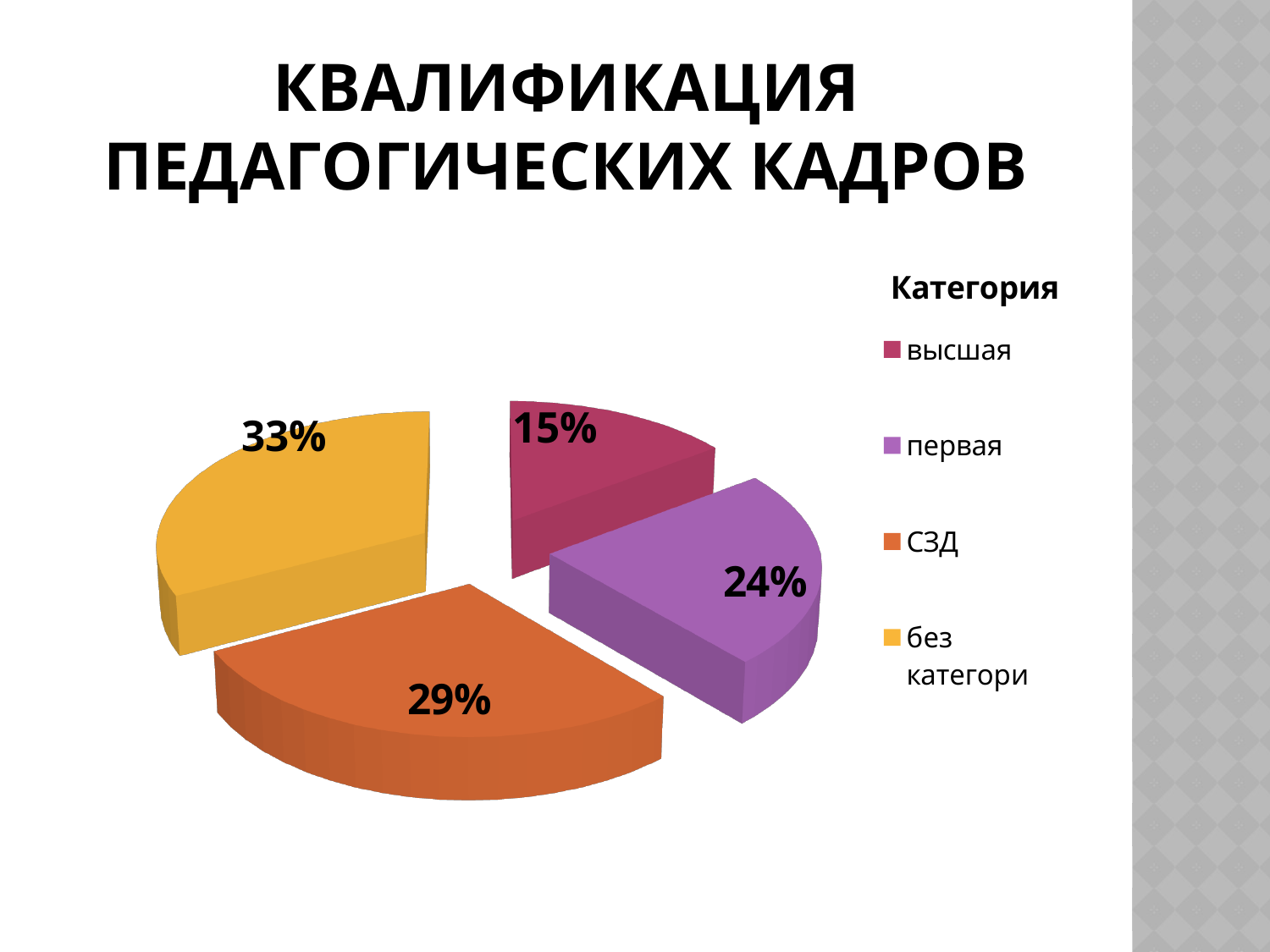
What is the title of the legend on the chart? Категория What is the difference in percentage points between the "без категори" slice and the "высшая" slice? 18 What percentage of the pie is labelled for the category "первая"? 24% What type of chart is shown on the slide? pie chart Which category has the smallest slice of the pie? высшая Which slice is larger, "СЗД" or "первая"? СЗД How many slices does the pie chart have? 4 Which category has the largest slice of the pie? без категори What percentage of the pie is labelled for the category "высшая"? 15% What percentage of the pie is labelled for the category "без категори"? 33% What colour is the slice for "СЗД"? orange What percentage of the pie is labelled for the category "СЗД"? 29%